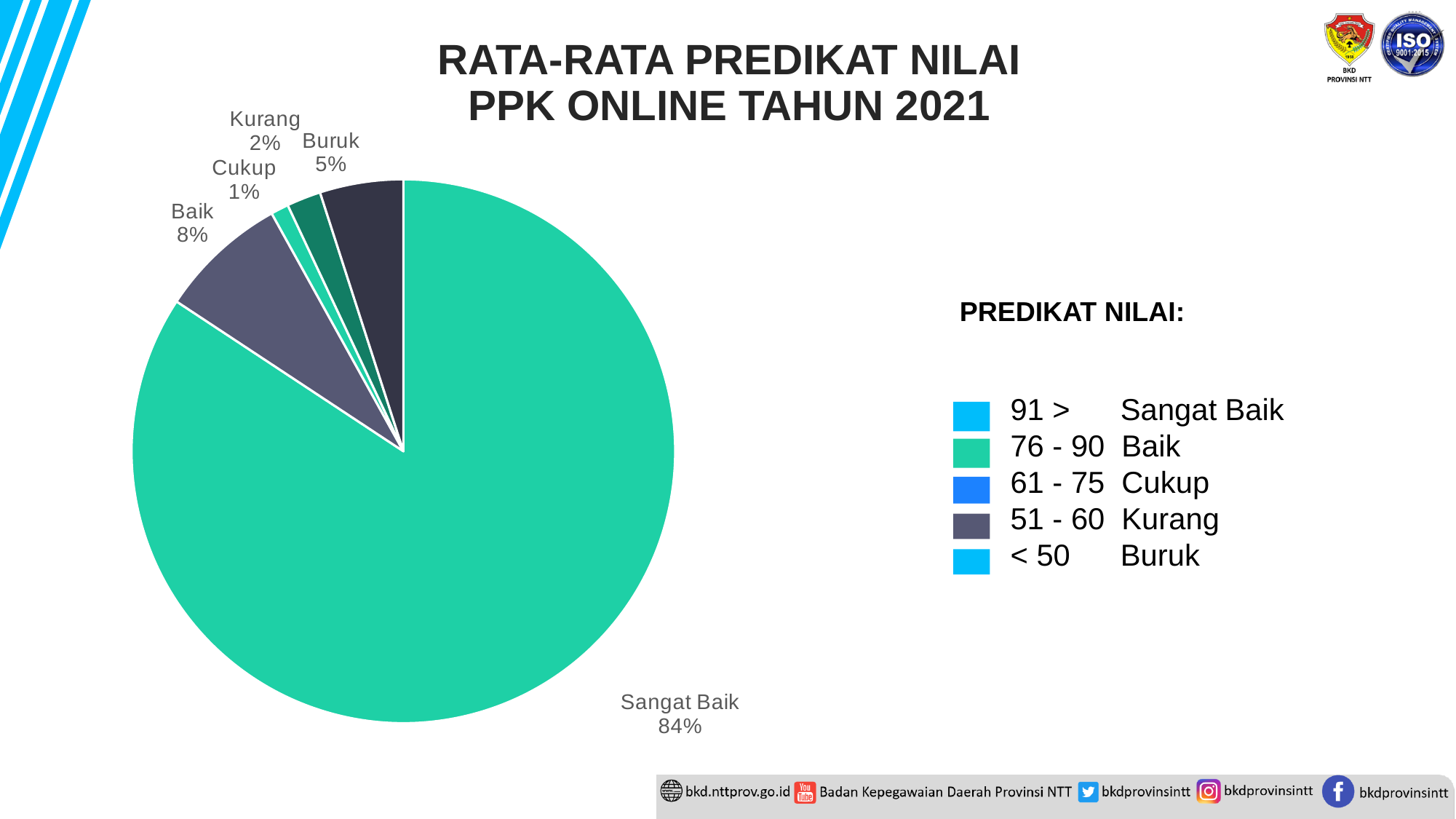
Which category has the smallest slice of the pie? Cukup What is the title of the chart on the slide? RATA-RATA PREDIKAT NILAI PPK ONLINE TAHUN 2021 What is the difference between the Baik and Buruk percentages? 3% What is the value shown for Cukup? 1% What is the value shown for Kurang? 2% How many slices does the pie chart have? 5 What type of chart is shown on the slide? Pie chart What is the value shown for Baik? 8% Which is larger, the Kurang slice or the Buruk slice? Buruk What share of the pie does Sangat Baik have? 84% Which category has the largest slice of the pie? Sangat Baik What is the value shown for Buruk? 5%